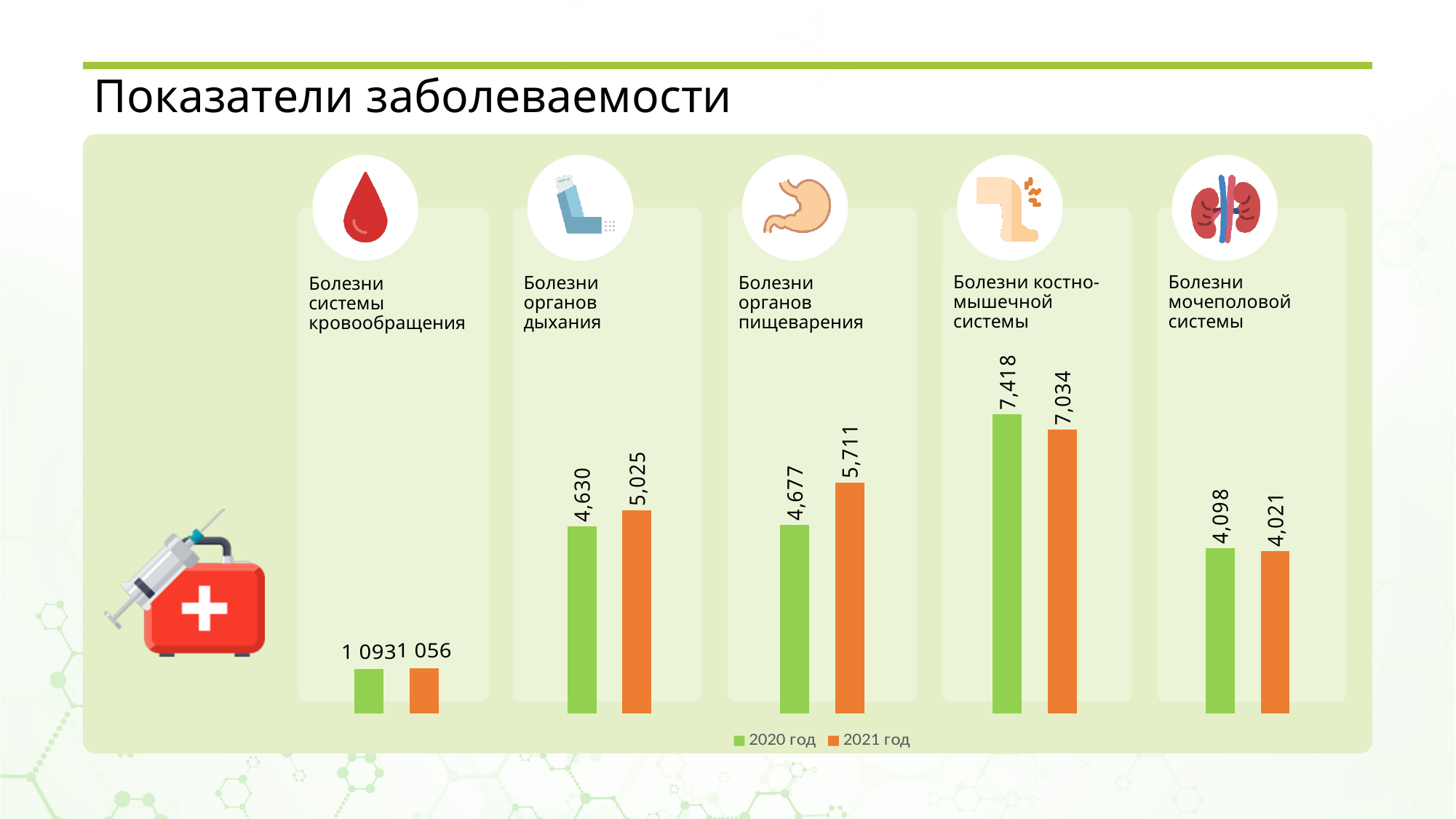
What is the difference between the 2021 год and 2020 год values for Болезни органов пищеварения? 1,034 What kind of chart is shown on the slide? Bar chart What is the value for Болезни органов дыхания in 2020 год? 4,630 How many series does the legend list? 2 For Болезни костно-мышечной системы, which year has the larger value, 2020 год or 2021 год? 2020 год What is the value for Болезни костно-мышечной системы in 2020 год? 7,418 Which category has the highest value in 2021 год? Болезни костно-мышечной системы What is the value for Болезни органов пищеварения in 2021 год? 5,711 Which colour represents 2021 год in the chart? Orange Which category has the lowest value in 2020 год? Болезни системы кровообращения What is the value for Болезни мочеполовой системы in 2021 год? 4,021 How many disease categories are shown in the chart? 5